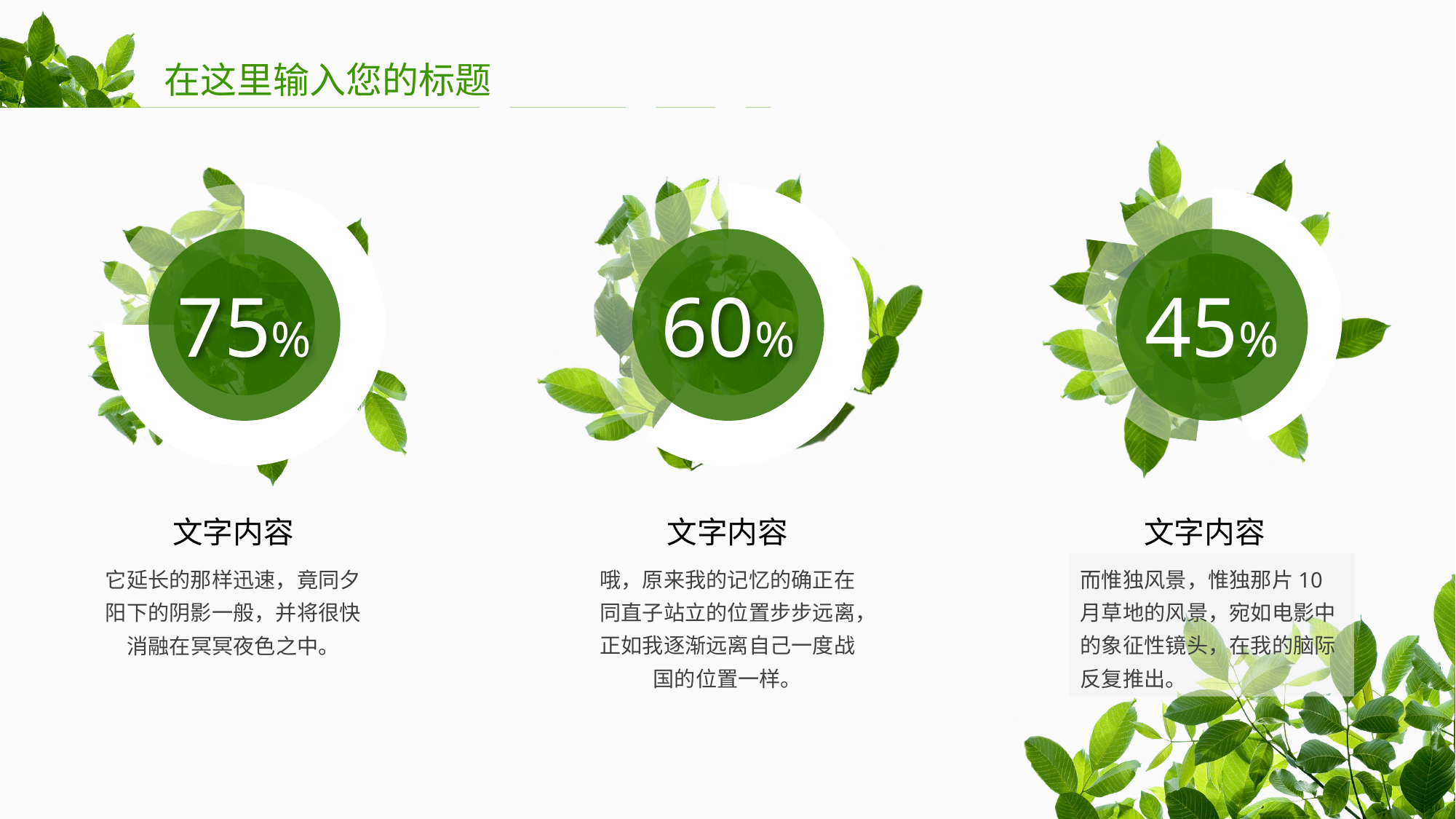
Which of the three circular charts shows the highest percentage? The left one (75%) What percentage is shown in the right circular chart? 45% What kind of chart is used to display the percentages on the slide? Donut (ring) chart What percentage is shown in the middle circular chart? 60% How many circular percentage charts are on the slide? 3 What is the difference between the percentages in the left and middle circular charts? 15% What is the title of the slide? 在这里输入您的标题 Do the percentages increase or decrease from the left chart to the right chart? Decrease Which of the three circular charts shows the lowest percentage? The right one (45%) What is the difference between the percentages in the left and right circular charts? 30% Which is larger, the percentage in the middle circular chart or the one in the right circular chart? The middle one (60%) What percentage is shown in the left circular chart? 75%